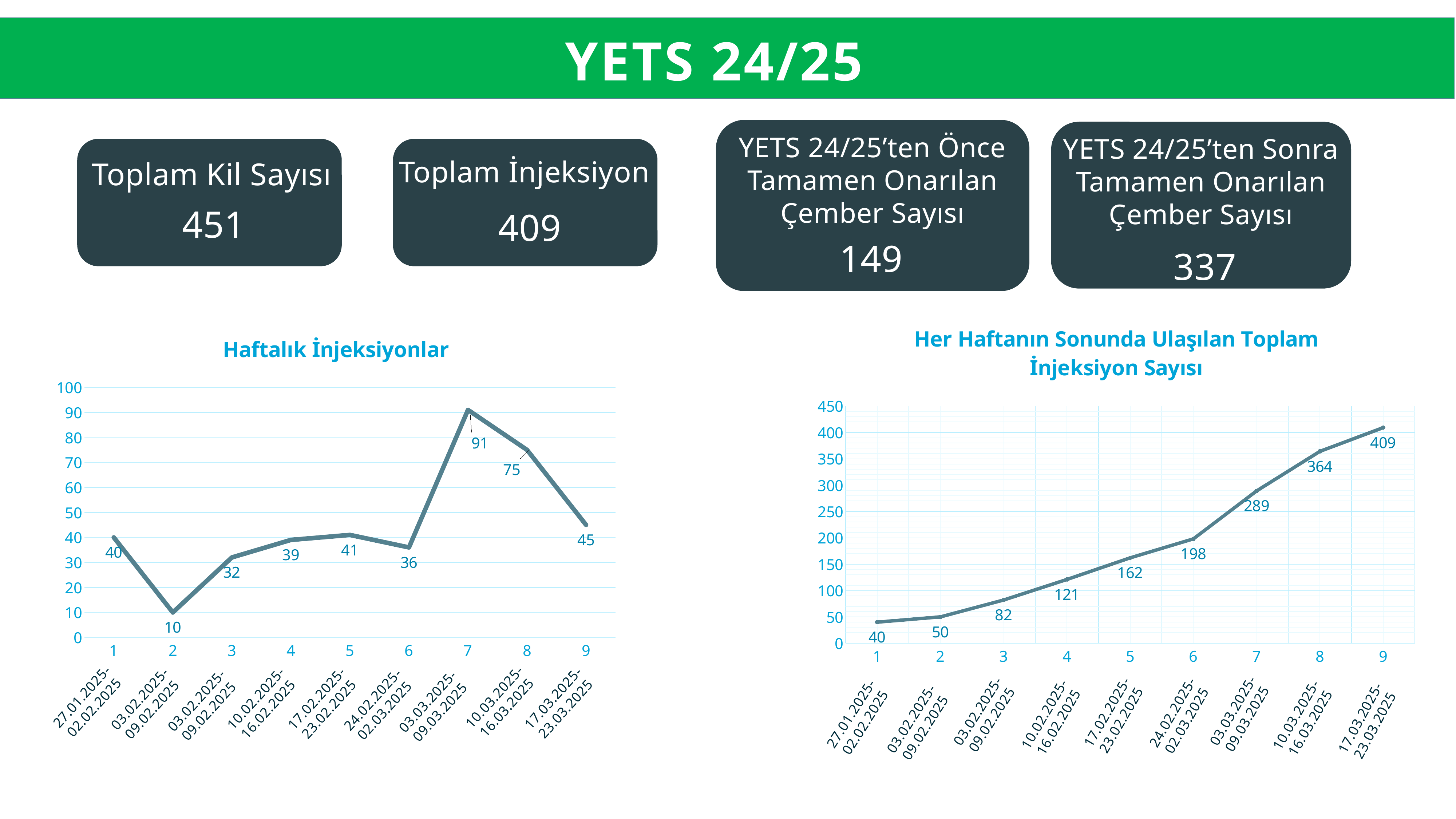
In the 'Her Haftanın Sonunda Ulaşılan Toplam İnjeksiyon Sayısı' chart, what is the value for week 5? 162 In the 'Haftalık İnjeksiyonlar' chart, how many weeks are plotted? 9 In the 'Haftalık İnjeksiyonlar' chart, which week has the lowest value? 2 What kind of chart is 'Haftalık İnjeksiyonlar'? Line chart In the 'Haftalık İnjeksiyonlar' chart, what is the difference between the values for week 7 and week 8? 16 In the 'Her Haftanın Sonunda Ulaşılan Toplam İnjeksiyon Sayısı' chart, what is the value for week 9? 409 In the 'Her Haftanın Sonunda Ulaşılan Toplam İnjeksiyon Sayısı' chart, what is the difference between the values for week 8 and week 7? 75 In the 'Haftalık İnjeksiyonlar' chart, which is larger, the value for week 4 or week 6? Week 4 In the 'Her Haftanın Sonunda Ulaşılan Toplam İnjeksiyon Sayısı' chart, what is the date range label for week 1? 27.01.2025-02.02.2025 In the 'Haftalık İnjeksiyonlar' chart, which week has the highest value? 7 In the 'Haftalık İnjeksiyonlar' chart, what is the value for week 7? 91 In the 'Her Haftanın Sonunda Ulaşılan Toplam İnjeksiyon Sayısı' chart, do the values rise or fall from week 1 to week 9? Rise